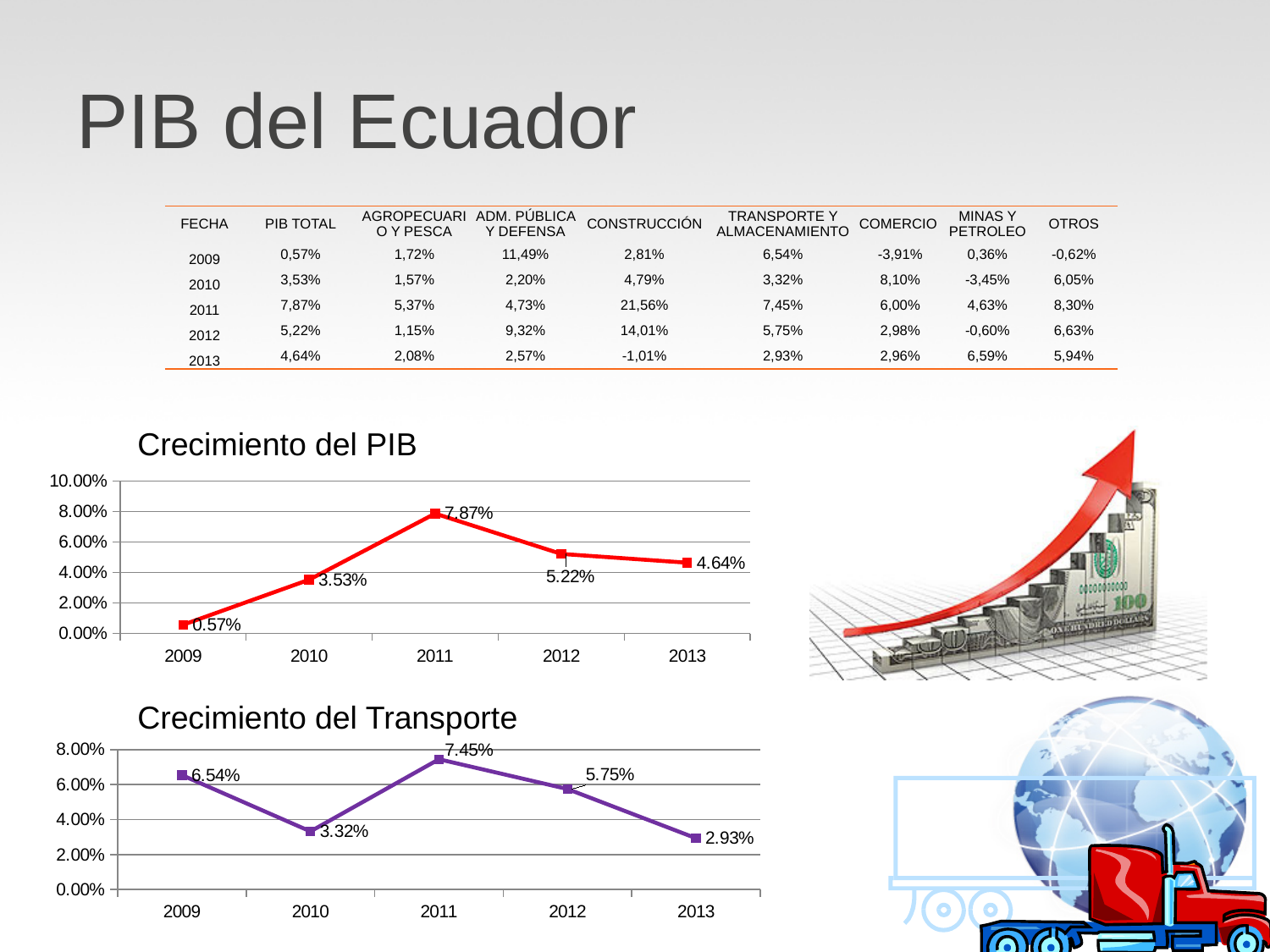
In the 'Crecimiento del Transporte' chart, which is larger, the value for 2009 or the value for 2012? 2009 In the 'Crecimiento del Transporte' chart, do the values rise or fall from 2011 to 2013? fall In the 'Crecimiento del PIB' chart, which year has the highest value? 2011 In the 'Crecimiento del PIB' chart, what is the value for 2009? 0.57% In the 'Crecimiento del Transporte' chart, what is the value for 2013? 2.93% In the 'Crecimiento del PIB' chart, which year has the lowest value? 2009 In the 'Crecimiento del Transporte' chart, which year has the highest value? 2011 In the 'Crecimiento del PIB' chart, how many data points are plotted? 5 In the 'Crecimiento del Transporte' chart, is the value for 2010 greater or less than 4.00%? less In the 'Crecimiento del PIB' chart, what is the difference between the 2011 and 2012 values? 2.65% In the 'Crecimiento del PIB' chart, what is the value for 2011? 7.87% What kind of chart is 'Crecimiento del PIB'? Line chart